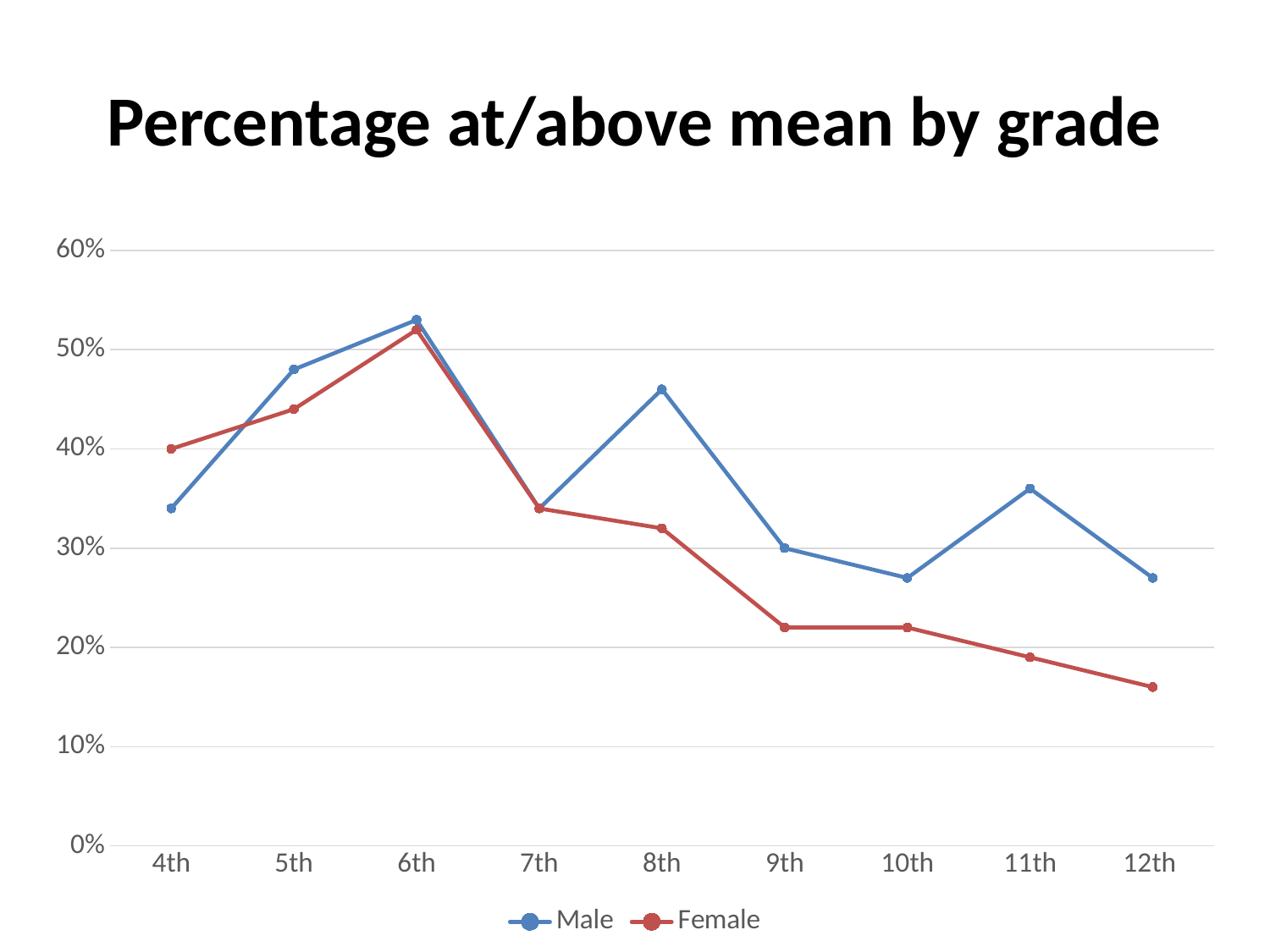
At 8th grade, which series has the larger value, Male or Female? Male What is the Female value for 4th grade? 40% Is the Male value for 8th grade greater or less than 40%? greater At which grade does the Male series reach its highest value? 6th Does the Female series rise or fall from 6th grade to 12th grade? Fall How many grade levels are plotted along the x axis? 9 What kind of chart is shown on the slide? Line chart At which grade does the Female series reach its lowest value? 12th Is the Female value for 12th grade greater or less than 20%? less How many series does the legend list? 2 At 4th grade, which series has the larger value, Male or Female? Female What is the Male value for 9th grade? 30%